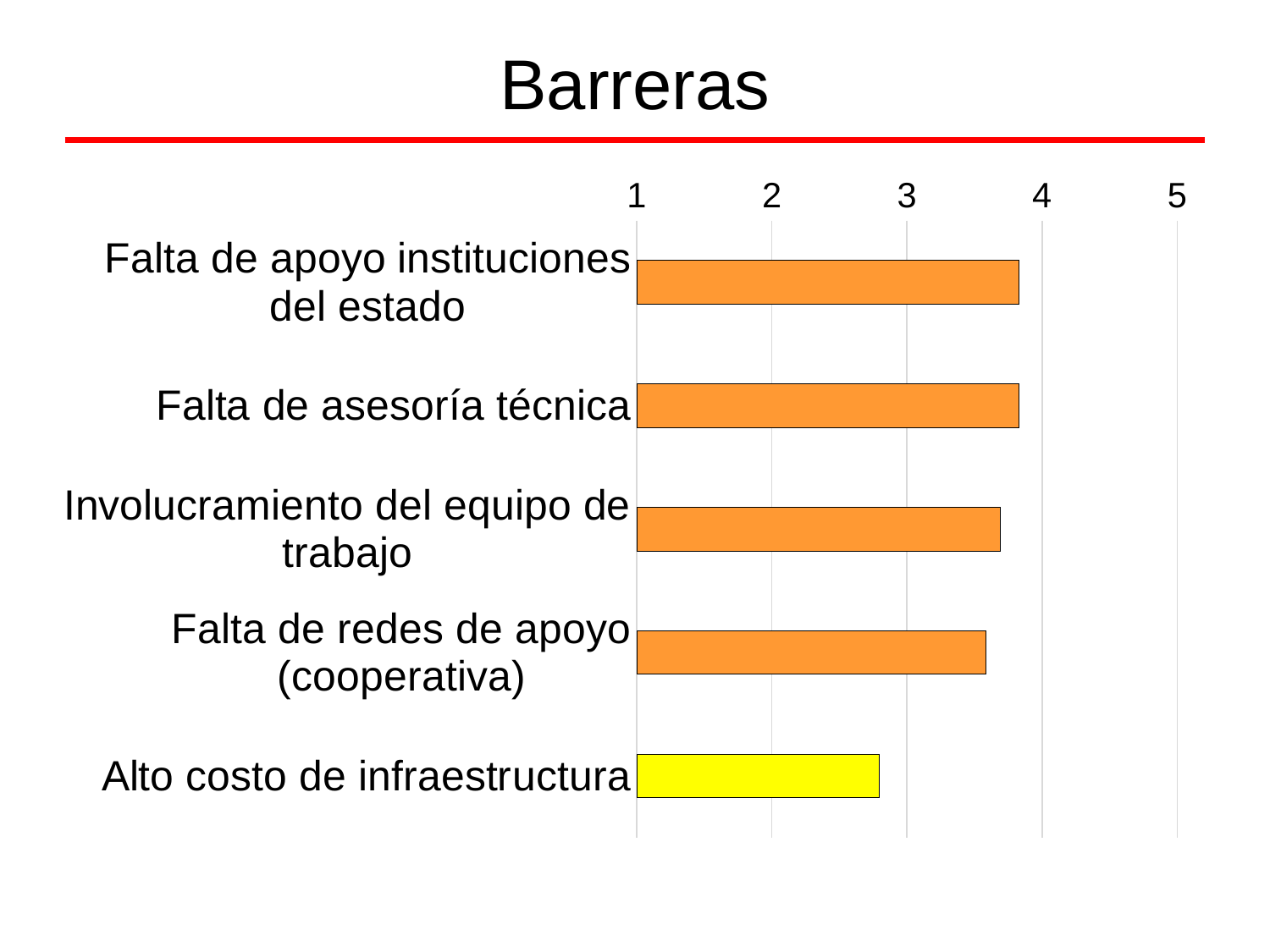
What colour is the bar for Alto costo de infraestructura? yellow Which has the larger value: Falta de asesoría técnica or Alto costo de infraestructura? Falta de asesoría técnica Is the value for Falta de apoyo instituciones del estado greater or less than 3? greater What is the title of the slide containing the chart? Barreras Is the value for Falta de redes de apoyo (cooperativa) greater or less than 3? greater Is the value for Involucramiento del equipo de trabajo greater or less than 4? less Which has the larger value: Falta de redes de apoyo (cooperativa) or Alto costo de infraestructura? Falta de redes de apoyo (cooperativa) What kind of chart is shown on the slide? bar chart Which barrier has the lowest value in the chart? Alto costo de infraestructura What is the highest value shown on the chart's value axis? 5 How many categories (barriers) are plotted in the chart? 5